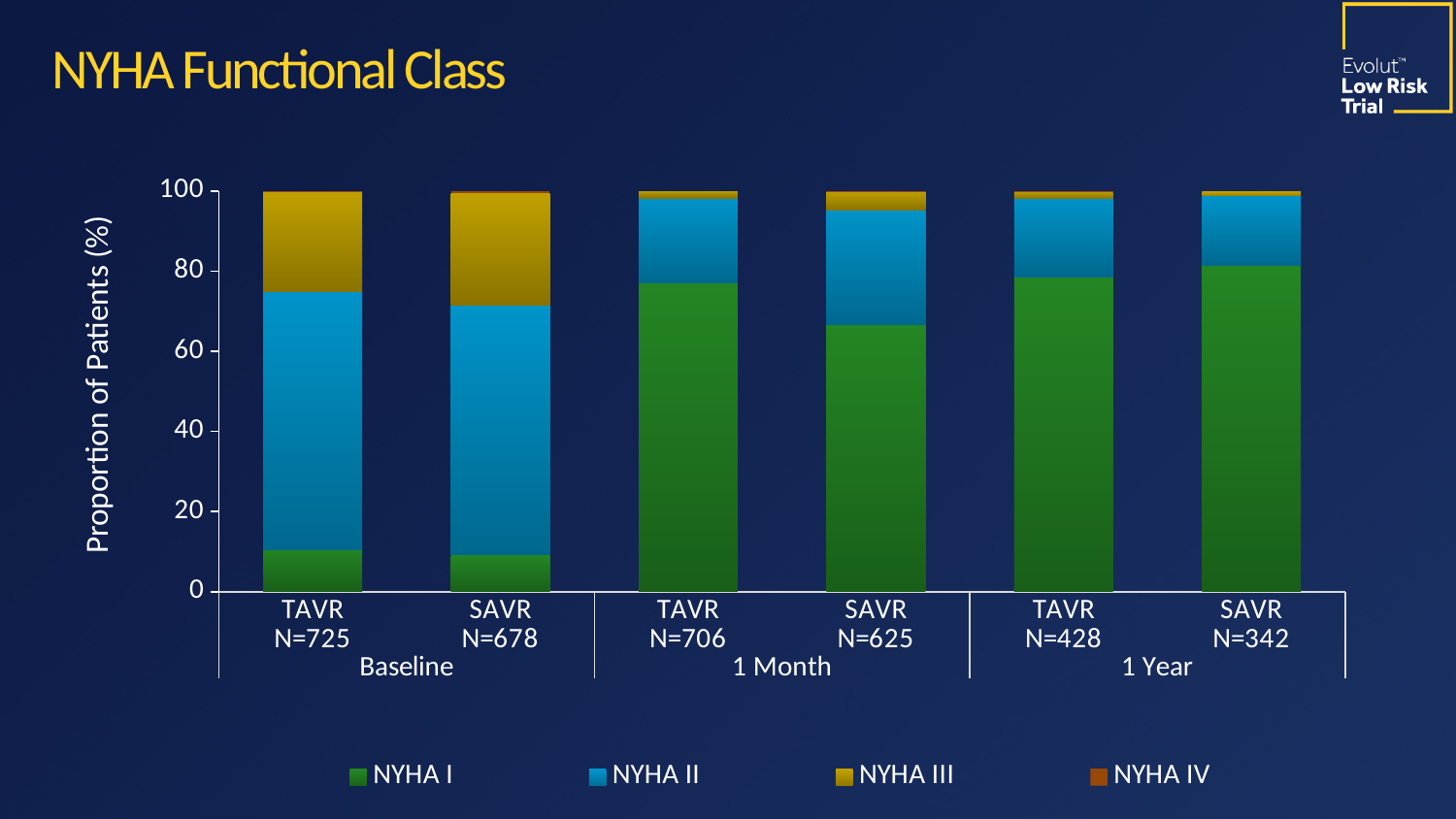
At 1 Month, which group has the larger NYHA I proportion, TAVR or SAVR? TAVR Is the NYHA I proportion for TAVR at 1 Month greater or less than 60? greater Does the NYHA I proportion for TAVR rise or fall from Baseline to 1 Year? rise What is the N shown for the TAVR group at 1 Year? N=428 How many series does the legend list? 4 What is the title of the chart? NYHA Functional Class How many bars are plotted in the chart? 6 Is the NYHA I proportion for SAVR at 1 Month greater or less than 60? greater Is the NYHA I proportion for TAVR at Baseline greater or less than 20? less What type of chart is shown on the slide? Stacked bar chart Which time point has the lowest NYHA I proportion for SAVR? Baseline